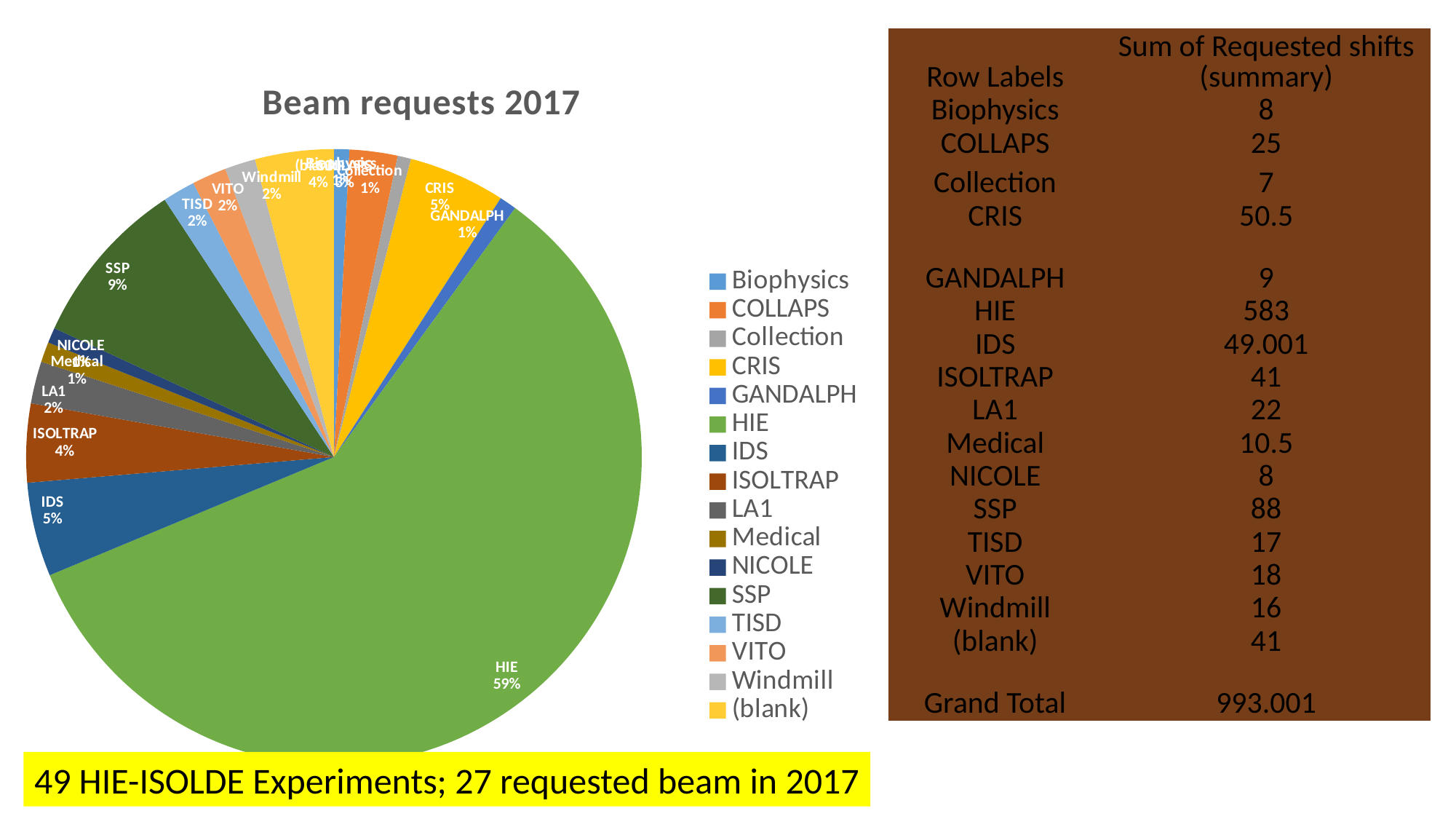
What type of chart is shown on the slide? pie chart What is the title of the pie chart? Beam requests 2017 Which is larger in the pie chart, the SSP slice or the IDS slice? SSP What percentage is shown for CRIS in the pie chart? 5% What is the difference in percentage points between the HIE slice and the SSP slice? 50 Which category has the largest slice of the pie chart? HIE What percentage is shown for ISOLTRAP in the pie chart? 4% What percentage is shown for IDS in the pie chart? 5% How many entries does the legend of the pie chart list? 16 What share of the pie does SSP account for? 9% What share of the pie does HIE account for? 59% What percentage is shown for LA1 in the pie chart? 2%